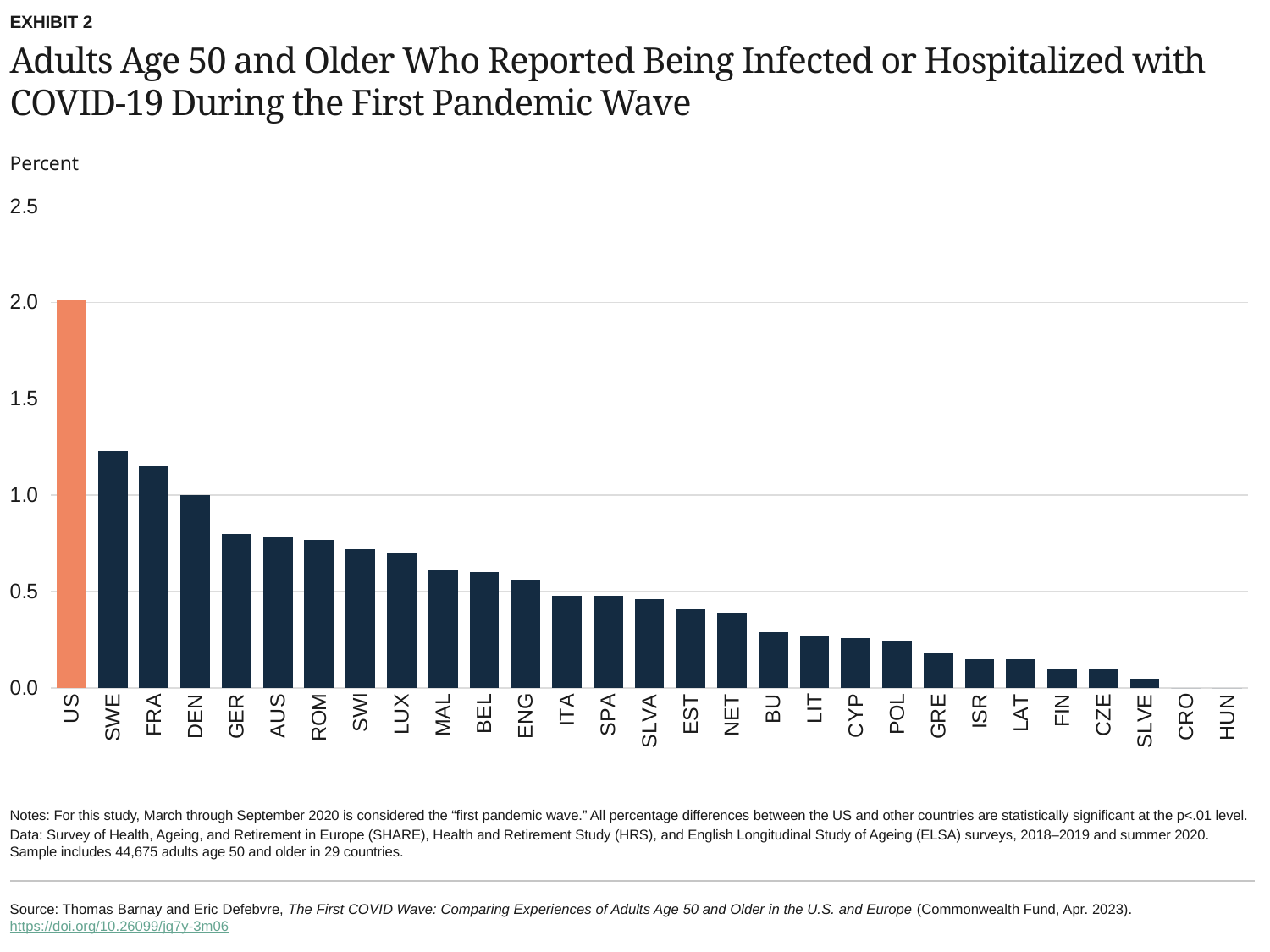
Is the value for US greater or less than 1.5? greater Is the value for FIN greater or less than 0.5? less What kind of chart is shown on the slide? bar chart Is the value for GER greater or less than 1.0? less Which has a higher value, US or SWE? US Which country has the highest percentage of adults age 50 and older reporting infection or hospitalization with COVID-19? US How many countries are shown on the x axis of the chart? 29 Which has a higher value, GER or ENG? GER Do the bar values rise or fall moving from left to right along the x axis? fall Which country's bar is shown in a different colour (orange) from the rest? US